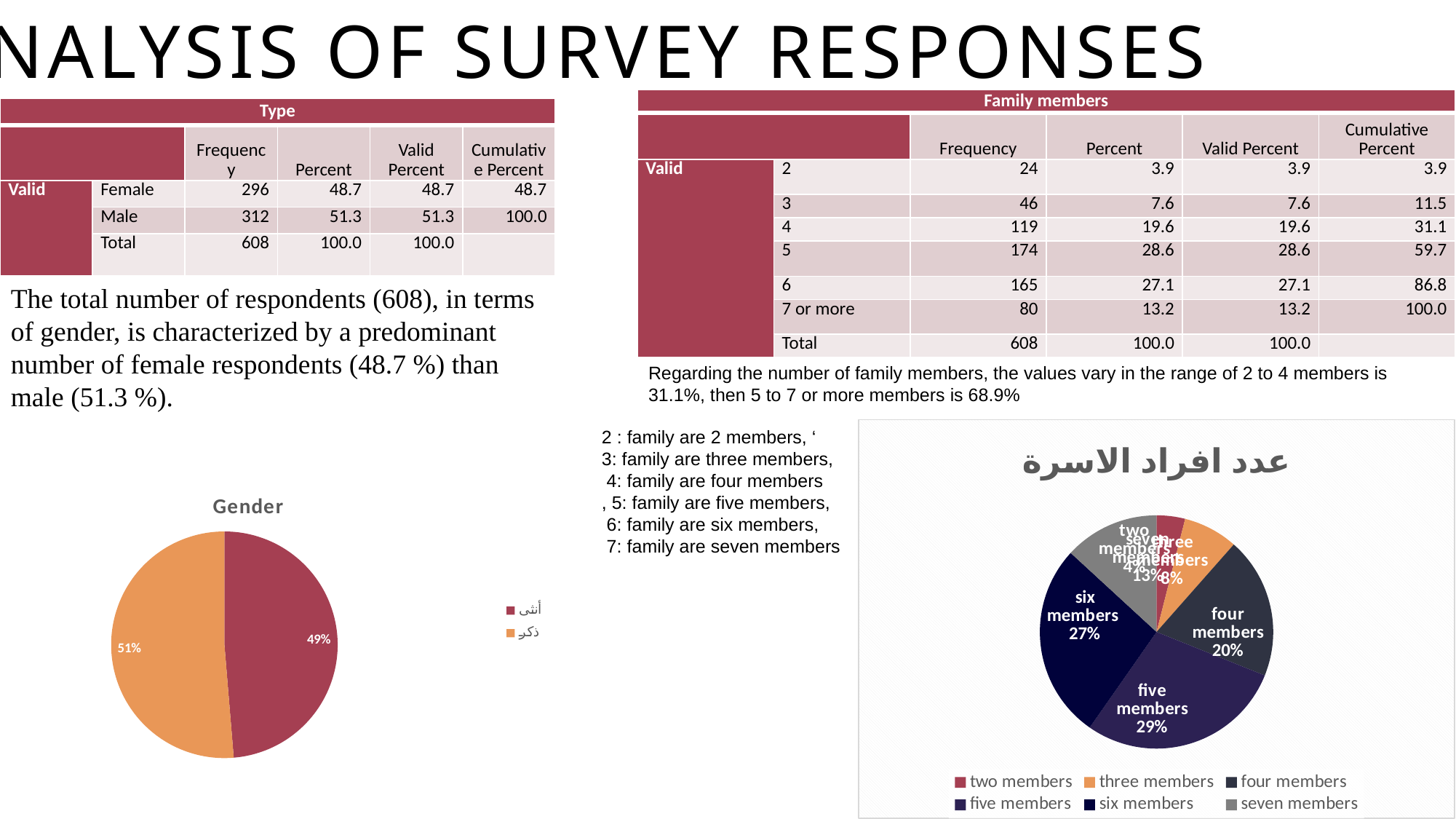
In the Gender pie chart, how many slices are there? 2 What kind of chart is the Gender chart? pie chart In the Gender pie chart, which slice is larger, the red one or the orange one? the orange one In the family members pie chart on the right, what share is labelled for four members? 20% In the family members pie chart on the right, how many entries does the legend list? 6 In the family members pie chart on the right, which category has the largest slice? five members What kind of chart is the family members chart on the right (titled عدد افراد الاسرة)? pie chart In the family members pie chart on the right, what share is labelled for five members? 29% In the family members pie chart on the right, what is the difference between the five members share and the four members share? 9% In the Gender pie chart, what share is shown on the red slice? 49%